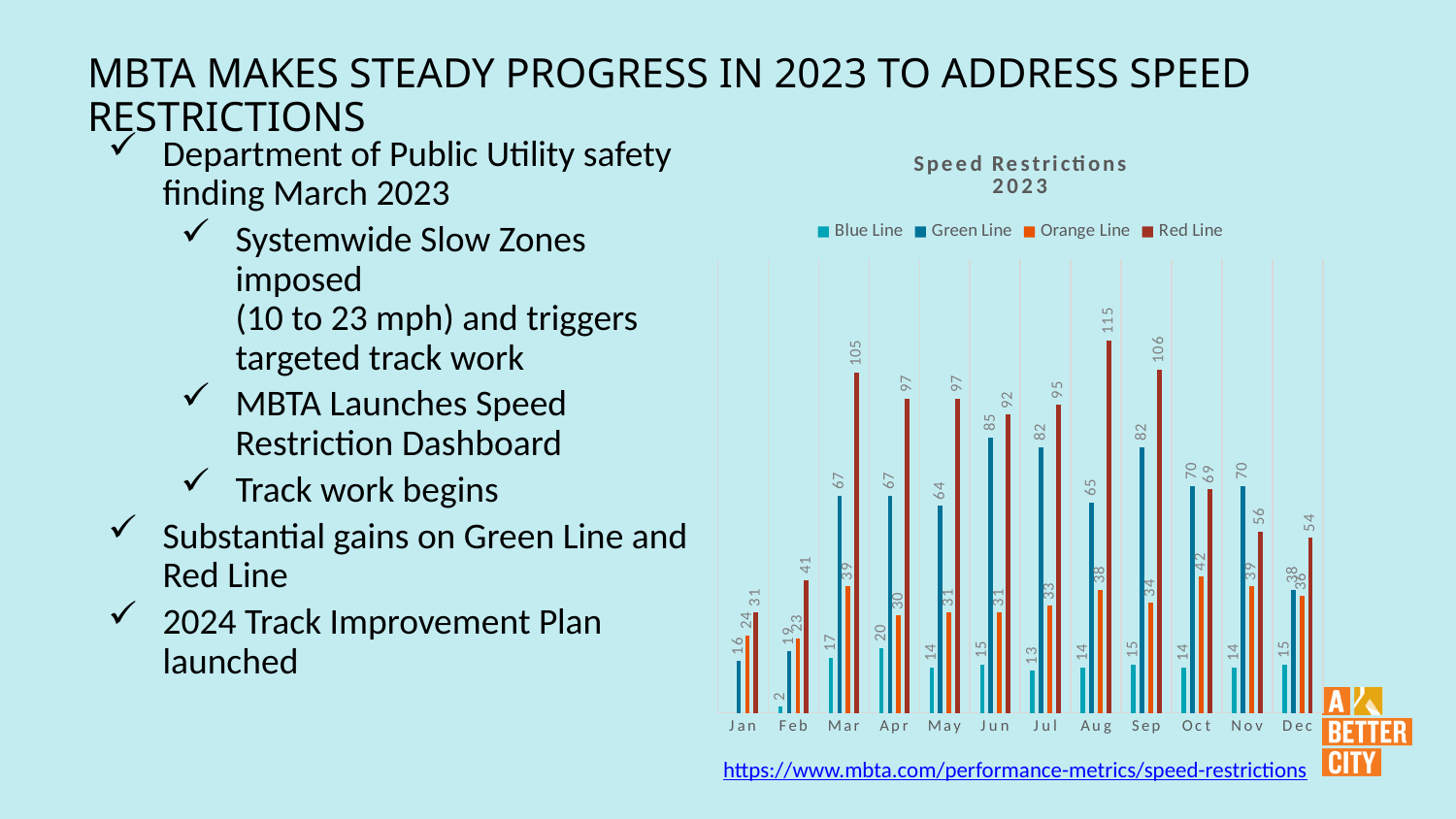
Do the Red Line values rise or fall from Sep to Dec? fall What is the Green Line value for Jun? 85 What is the Blue Line value for Feb? 2 What is the Red Line value for Aug? 115 What is the difference between the Red Line values for Aug and Sep? 9 In Nov, which is larger: the Green Line value or the Red Line value? Green Line In which month is the Red Line value highest? Aug How many series does the legend of the Speed Restrictions 2023 chart list? 4 How many months are shown on the x axis of the chart? 12 What is the title of the chart? Speed Restrictions 2023 What kind of chart is shown on the slide? bar chart What is the Red Line value for Mar? 105